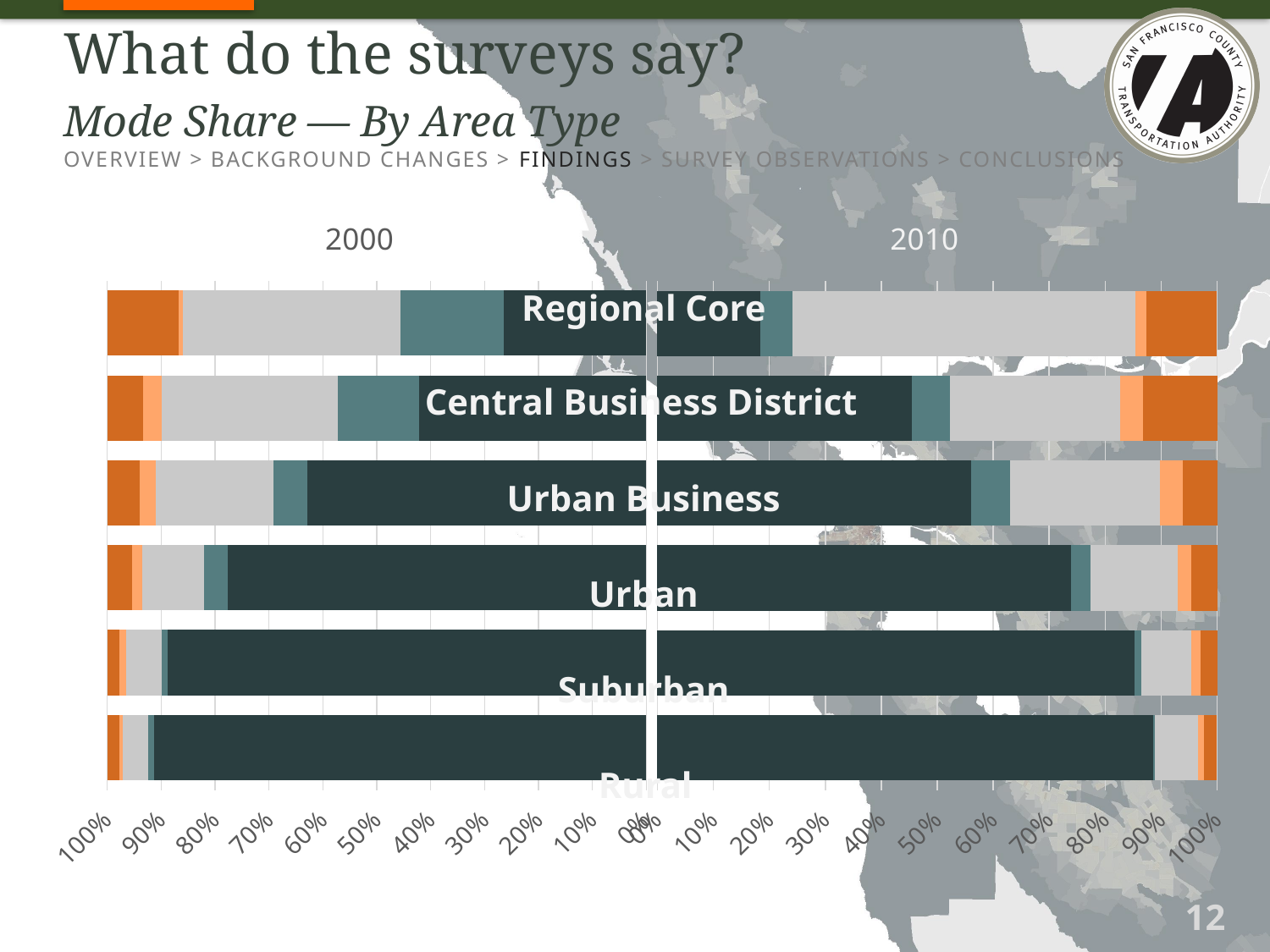
What kind of chart is shown on the slide? bar chart In the 2010 bars, which area type has the smallest dark teal segment? Regional Core How many area types are shown in the chart? 6 In the 2000 bars, which area type has the largest light grey segment? Regional Core In the 2000 bars, which area type has the smallest dark teal segment? Regional Core Which two years does the chart compare? 2000 and 2010 In the 2000 bars, is the dark teal segment for Urban greater or less than 70%? greater In the 2010 bars, is the dark teal segment for Regional Core greater or less than 30%? less Which year's bars are on the left side of the chart? 2000 In the 2000 bars, is the dark teal segment for Rural greater or less than 80%? greater In the 2010 bars, which area type has the largest light grey segment? Regional Core In the 2000 bars, which area type has the largest dark orange segment? Regional Core